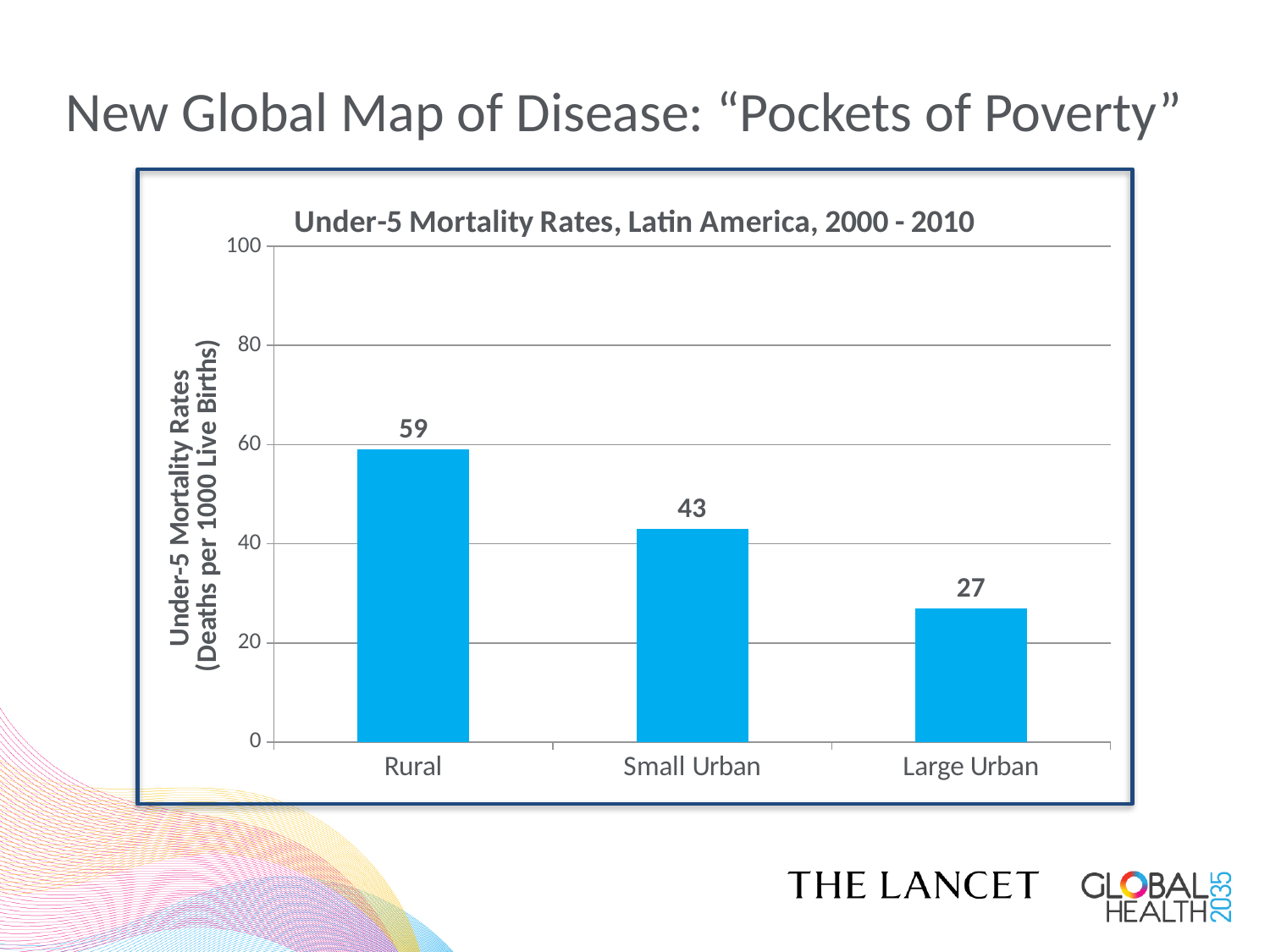
Is the value for Rural greater or less than 60? less What is the difference between the Rural and Large Urban under-5 mortality rates? 32 Which has a higher under-5 mortality rate, Small Urban or Large Urban? Small Urban Which category has the lowest under-5 mortality rate? Large Urban What kind of chart is shown on the slide? Bar chart Which category has the highest under-5 mortality rate? Rural What is the under-5 mortality rate for Small Urban? 43 What is the difference between the Rural and Small Urban under-5 mortality rates? 16 What is the under-5 mortality rate for Large Urban? 27 How many categories are shown on the x axis? 3 What is the title of the chart? Under-5 Mortality Rates, Latin America, 2000 - 2010 What is the under-5 mortality rate for Rural? 59